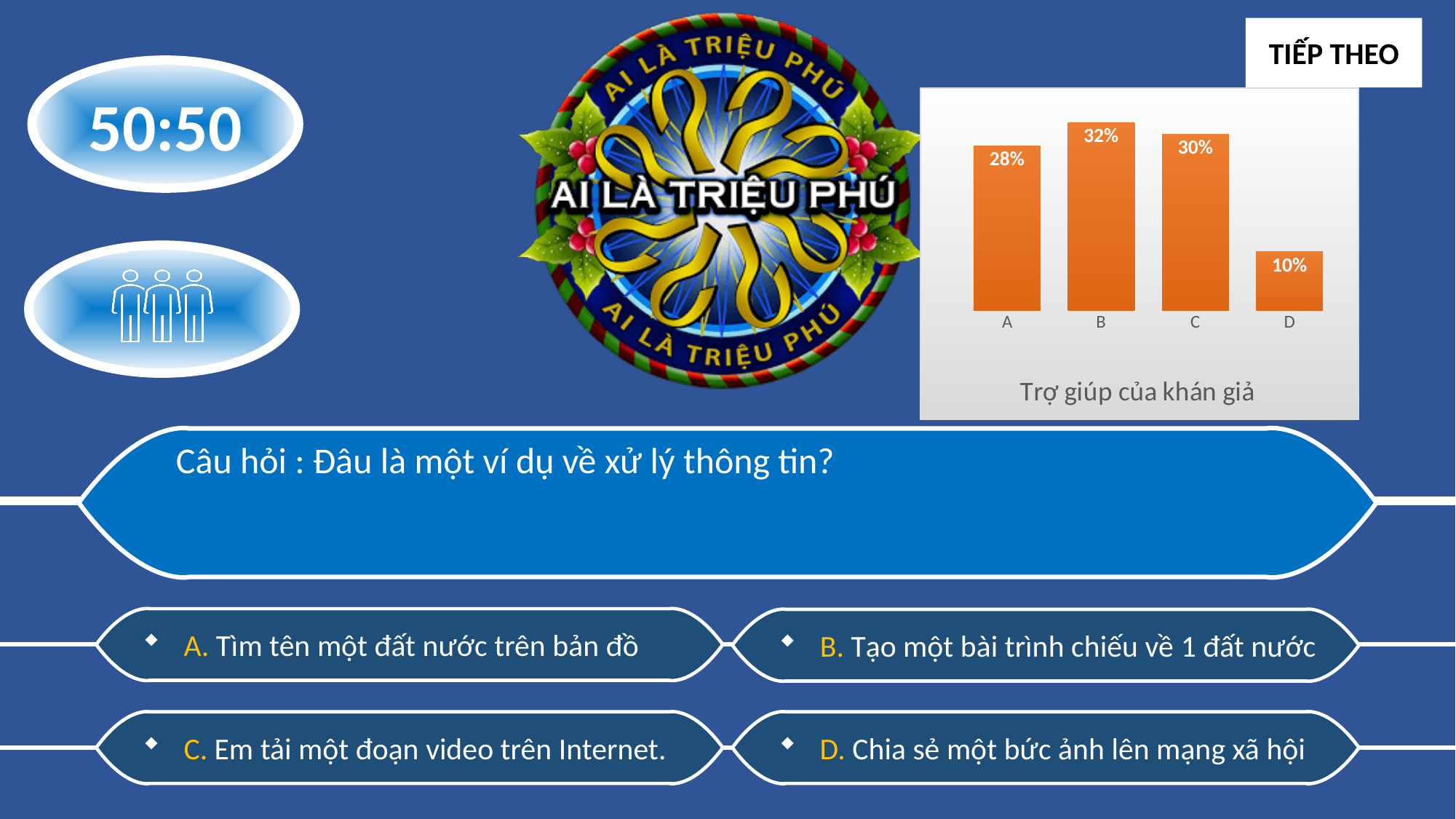
Which category has the lowest value in the chart? D What is the value for category C in the chart? 30% What is the value for category A in the chart? 28% Which is larger, the value for A or the value for D? A What is the value for category D in the chart? 10% What is the difference between the values for C and A? 2% What is the difference between the values for B and D? 22% What kind of chart is shown on the slide? Bar chart How many categories are shown in the chart? 4 Which category has the highest value in the chart? B What is the value for category B in the chart? 32% What is the title of the chart? Trợ giúp của khán giả